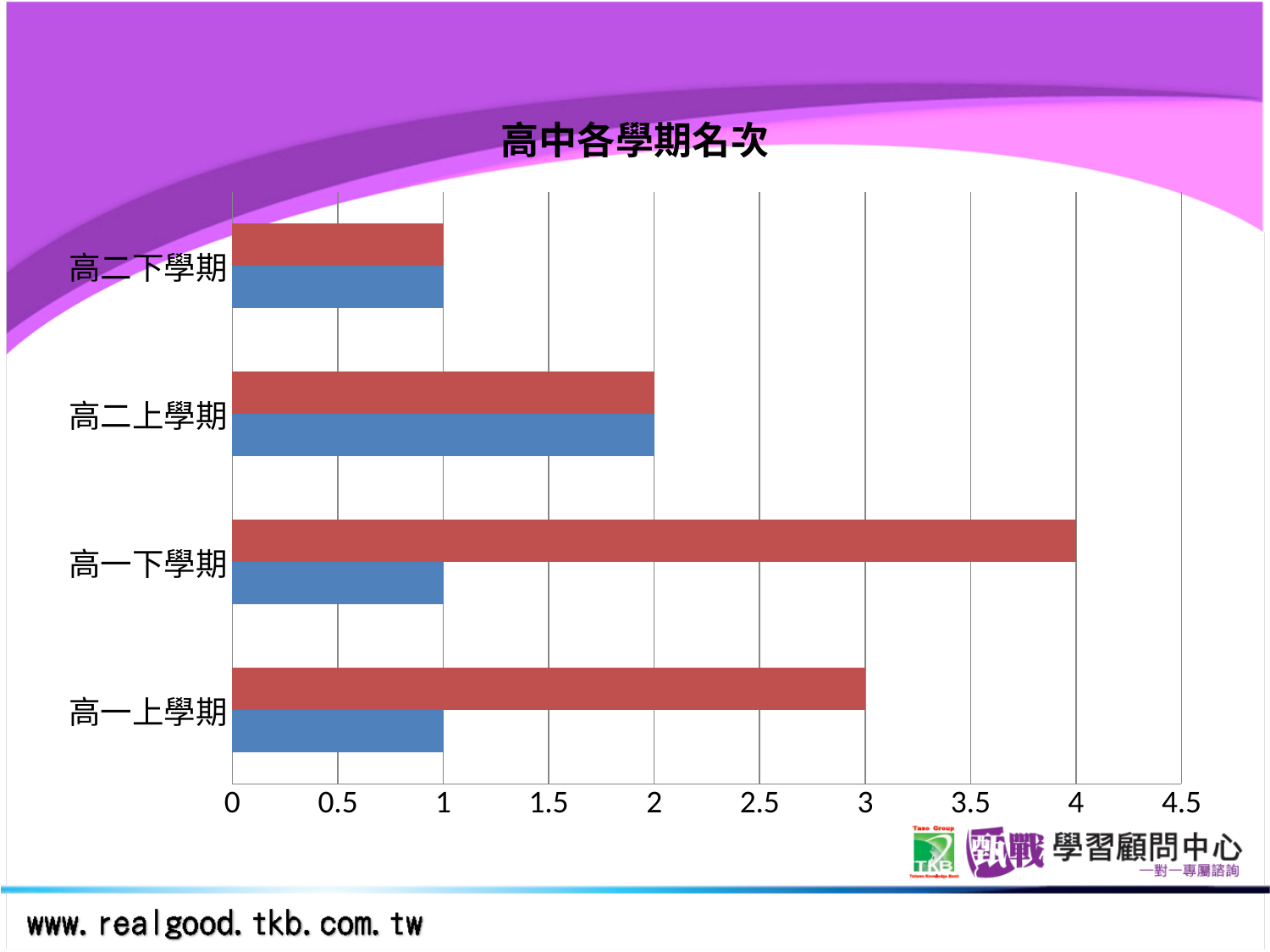
How many categories (semesters) are shown on the chart? 4 Which is larger for 高一上學期, the red bar or the blue bar? the red bar Which semester has the highest red bar value? 高一下學期 What is the difference between the red bar and the blue bar for 高一下學期? 3 What kind of chart is shown on the slide? bar chart What is the value of the blue bar for 高一下學期? 1 Which semester has the highest blue bar value? 高二上學期 What is the value of the red bar for 高一上學期? 3 What is the value of the blue bar for 高二上學期? 2 Is the red bar for 高一上學期 greater or less than 2? greater What is the title of the chart? 高中各學期名次 What is the value of the red bar for 高一下學期? 4